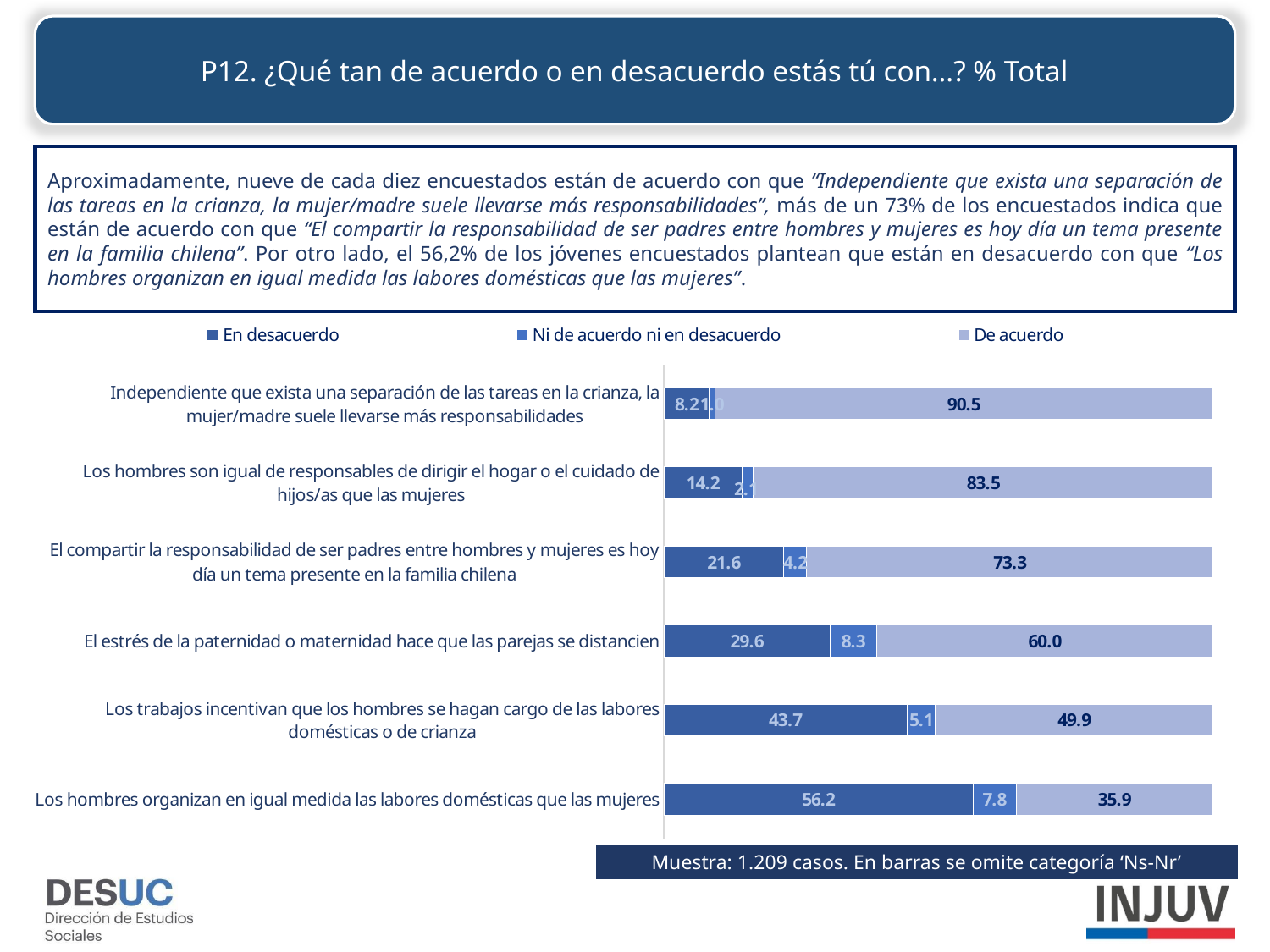
Which statement has the highest 'De acuerdo' value? Independiente que exista una separación de las tareas en la crianza, la mujer/madre suele llevarse más responsabilidades How many series does the legend list? 3 What is the 'En desacuerdo' value for 'Los hombres organizan en igual medida las labores domésticas que las mujeres'? 56.2 What is the difference between the 'De acuerdo' values for 'El estrés de la paternidad o maternidad hace que las parejas se distancien' and 'Los hombres organizan en igual medida las labores domésticas que las mujeres'? 24.1 For 'Los trabajos incentivan que los hombres se hagan cargo de las labores domésticas o de crianza', which is larger: 'En desacuerdo' or 'De acuerdo'? De acuerdo Which legend entry is shown in the lightest shade of blue? De acuerdo How many statements (categories) are plotted in the chart? 6 What is the total of the three plotted values for 'El compartir la responsabilidad de ser padres entre hombres y mujeres es hoy día un tema presente en la familia chilena'? 99.1 What is the 'Ni de acuerdo ni en desacuerdo' value for 'El estrés de la paternidad o maternidad hace que las parejas se distancien'? 8.3 What type of chart is shown on the slide? Stacked bar chart Which statement has the lowest 'En desacuerdo' value? Independiente que exista una separación de las tareas en la crianza, la mujer/madre suele llevarse más responsabilidades What is the 'De acuerdo' value for 'Independiente que exista una separación de las tareas en la crianza, la mujer/madre suele llevarse más responsabilidades'? 90.5